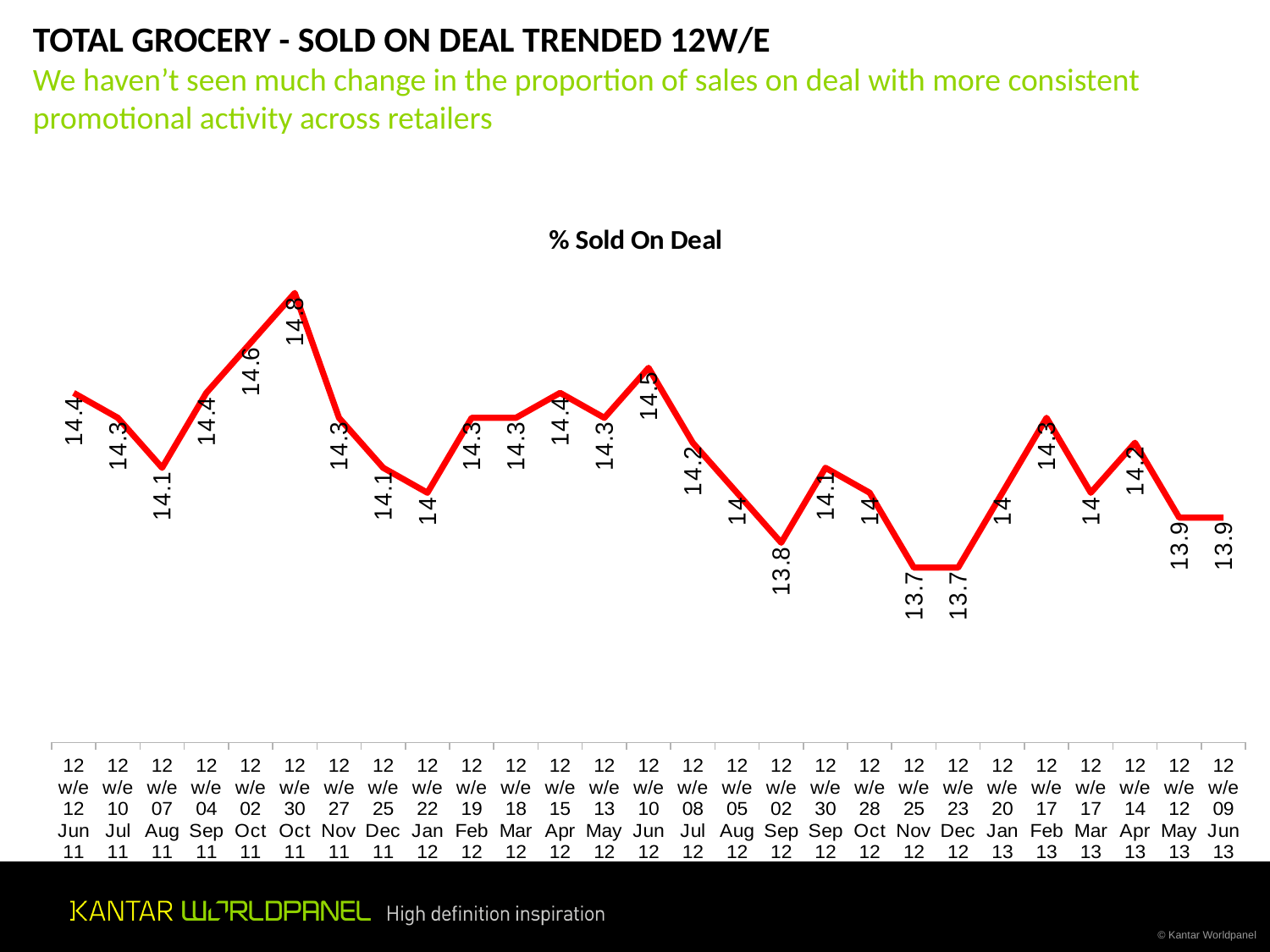
How many data points are plotted on the chart? 27 What is the % Sold On Deal value for 12 w/e 02 Sep 12? 13.8 Which is higher, the % Sold On Deal for 12 w/e 10 Jun 12 or for 12 w/e 08 Jul 12? 12 w/e 10 Jun 12 Does the % Sold On Deal rise or fall between 12 w/e 12 Jun 11 and 12 w/e 09 Jun 13? fall What is the difference between the % Sold On Deal for 12 w/e 30 Oct 11 and 12 w/e 25 Nov 12? 1.1 Which period has the highest % Sold On Deal? 12 w/e 30 Oct 11 What is the lowest % Sold On Deal value shown on the chart? 13.7 What colour is the line in the chart? red What is the % Sold On Deal value for 12 w/e 09 Jun 13? 13.9 What is the title of the chart? % Sold On Deal What type of chart is shown on the slide? line chart What is the % Sold On Deal value for 12 w/e 30 Oct 11? 14.8